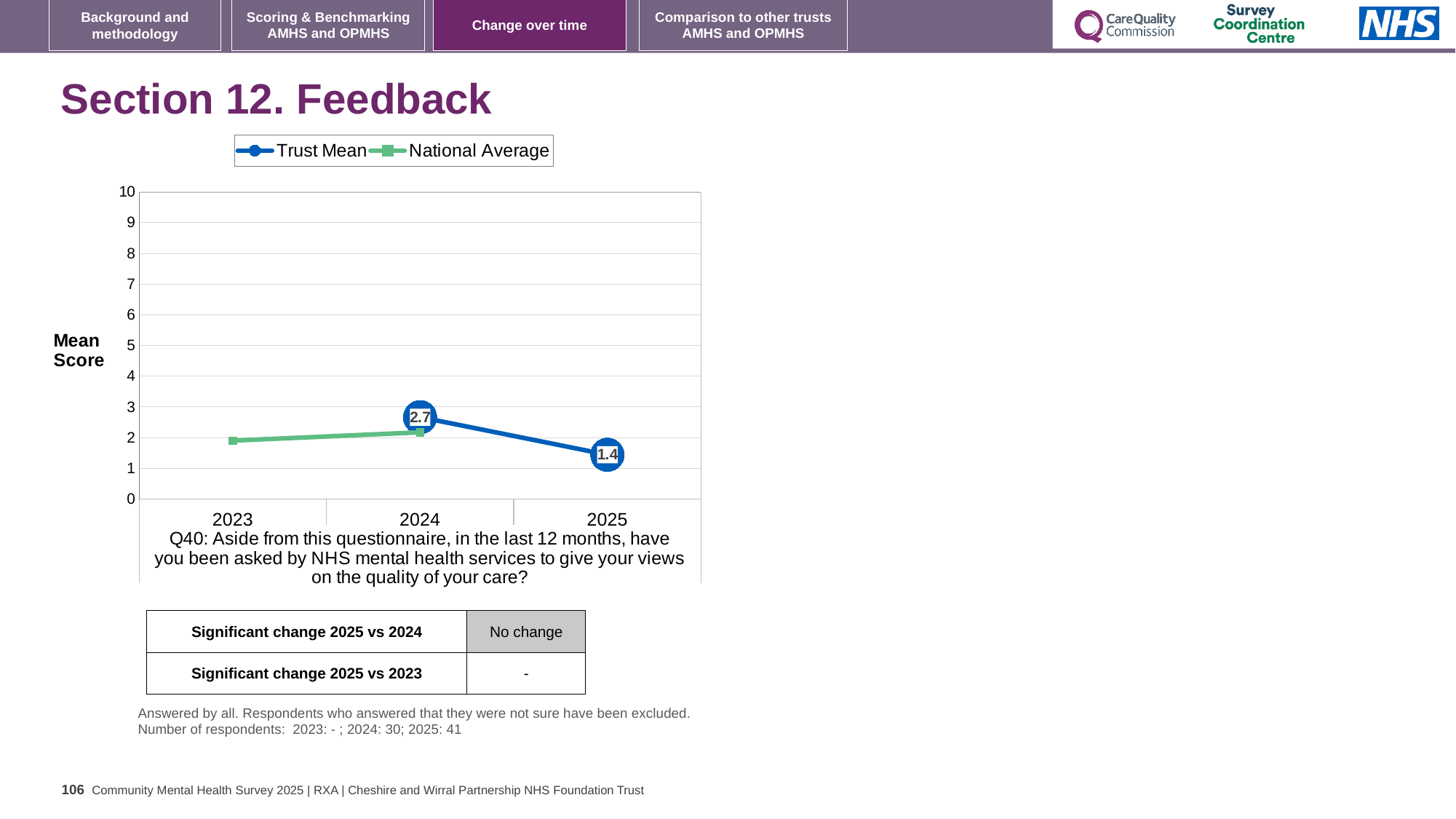
What is the difference between the Trust Mean in 2024 and in 2025? 1.3 What is the label on the y axis of the chart? Mean Score Is the Trust Mean value for 2025 greater or less than 2? less What is the Trust Mean value for 2024? 2.7 What is the Trust Mean value for 2025? 1.4 What kind of chart is shown on the slide? line chart What is the maximum value shown on the y axis? 10 How many series does the legend list? 2 Which year has the higher Trust Mean, 2024 or 2025? 2024 Is the National Average value for 2023 greater or less than 3? less Does the Trust Mean rise or fall from 2024 to 2025? fall How many years are shown on the x axis? 3